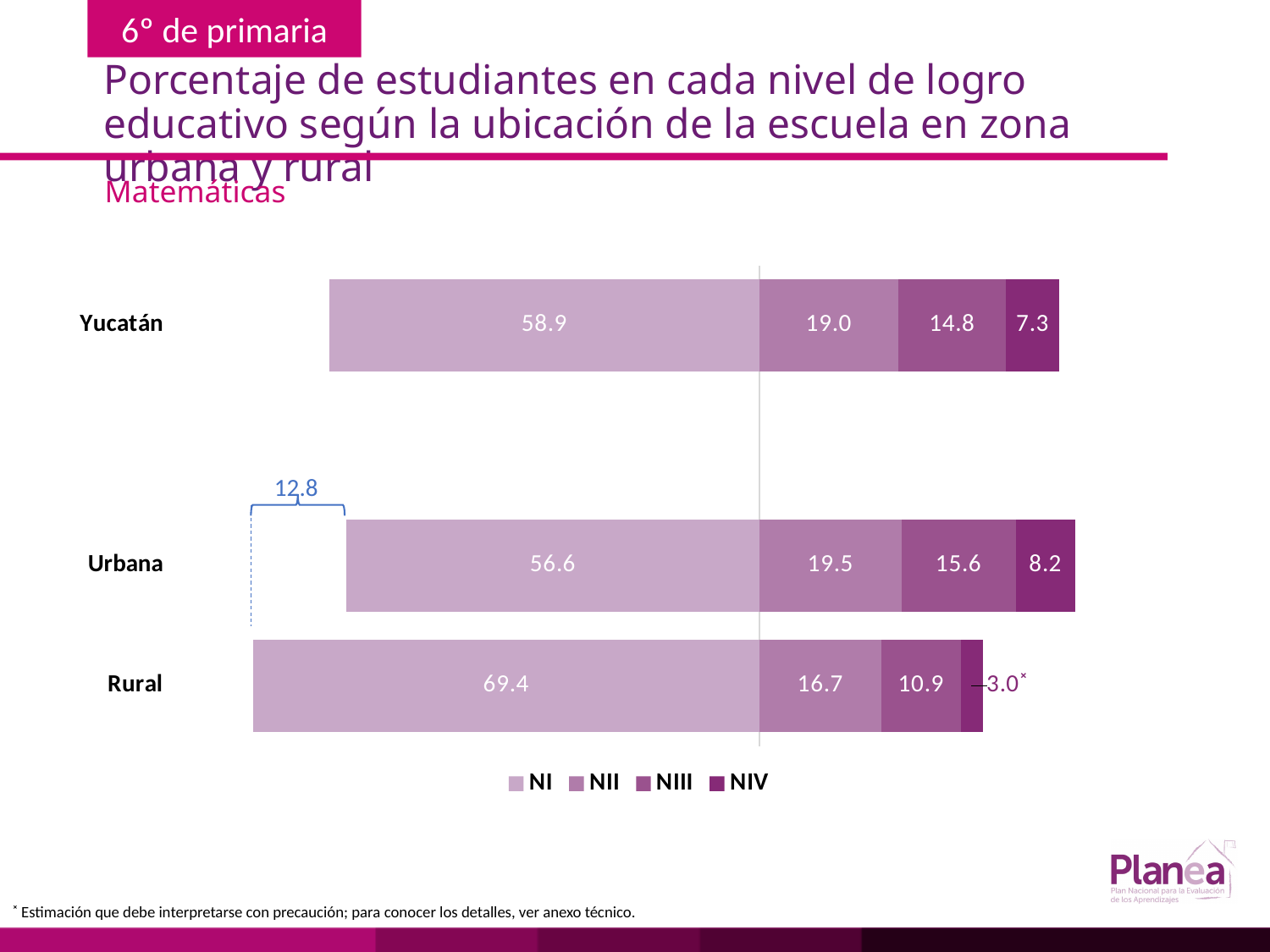
What is the NII value for Yucatán? 19.0 What percentage of Rural students are at level NI? 69.4 What is the NIII value for Rural? 10.9 Which is larger, the NIII value for Urbana or for Yucatán? Urbana Which category has the highest NI value? Rural What is the difference between the NI values for Rural and Urbana? 12.8 What type of chart is shown on the slide? Stacked bar chart What is the total of the stacked bar for Yucatán? 100.0 How many categories (bars) are shown in the chart? 3 What is the NIV value for Urbana? 8.2 How many series does the legend list? 4 Which category has the lowest NIV value? Rural